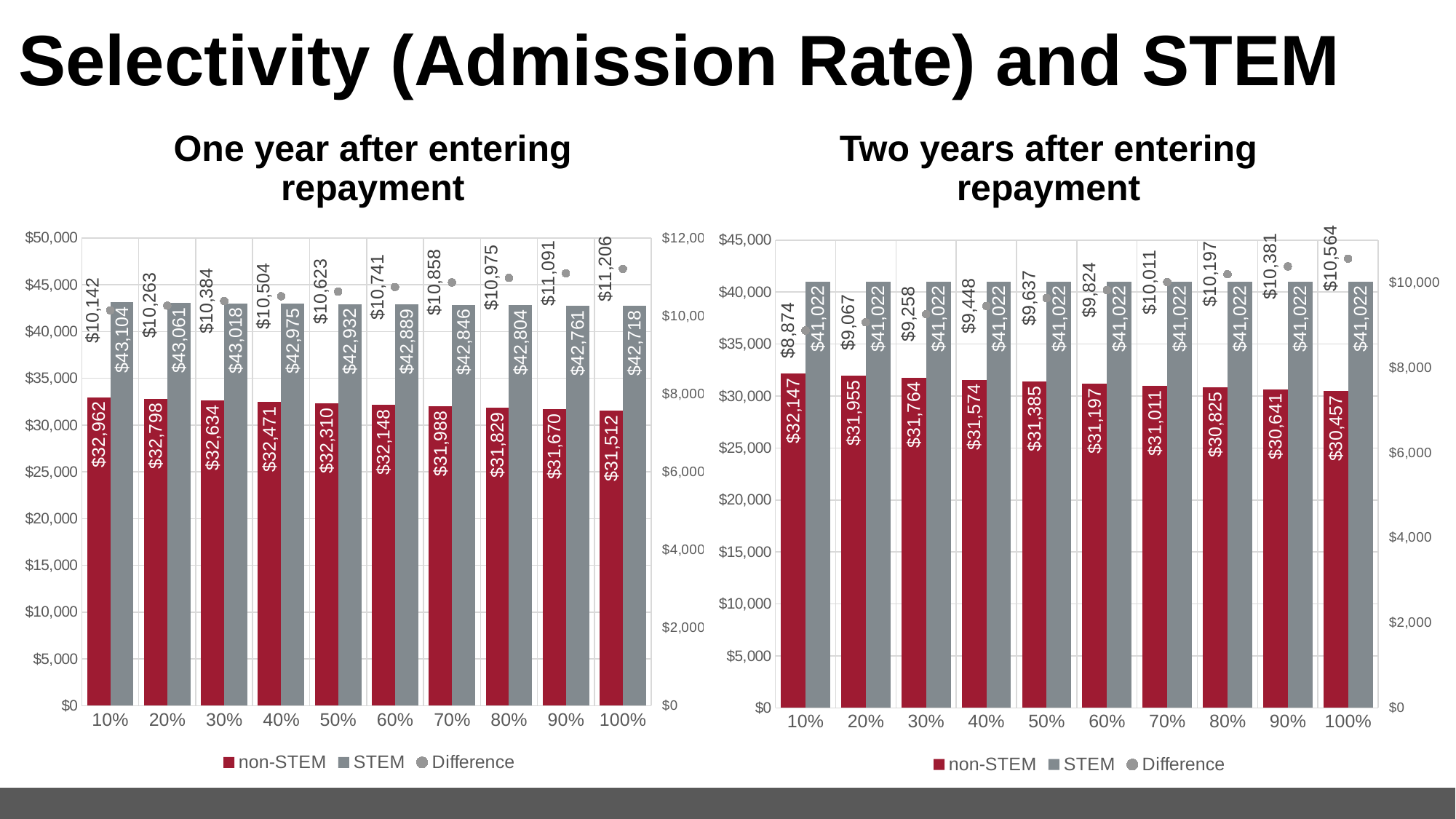
In the 'One year after entering repayment' chart, what is the STEM value at 100%? $42,718 In the 'One year after entering repayment' chart, what is the non-STEM value at 10%? $32,962 In the 'One year after entering repayment' chart, what is the Difference value at 50%? $10,623 In the 'One year after entering repayment' chart, which admission rate category has the highest STEM value? 10% In the 'Two years after entering repayment' chart, is the non-STEM value at 10% larger or smaller than the non-STEM value at 90%? larger In the 'Two years after entering repayment' chart, what is the Difference value at 100%? $10,564 How many series does the legend of the 'One year after entering repayment' chart list? 3 In the 'One year after entering repayment' chart, do the non-STEM values rise or fall as the admission rate increases from 10% to 100%? fall In the 'Two years after entering repayment' chart, which admission rate category has the lowest non-STEM value? 100% In the 'One year after entering repayment' chart, what is the difference between the STEM and non-STEM values at 10%? $10,142 In the 'Two years after entering repayment' chart, what is the non-STEM value at 40%? $31,574 How many admission rate categories are shown on the x axis of the 'Two years after entering repayment' chart? 10